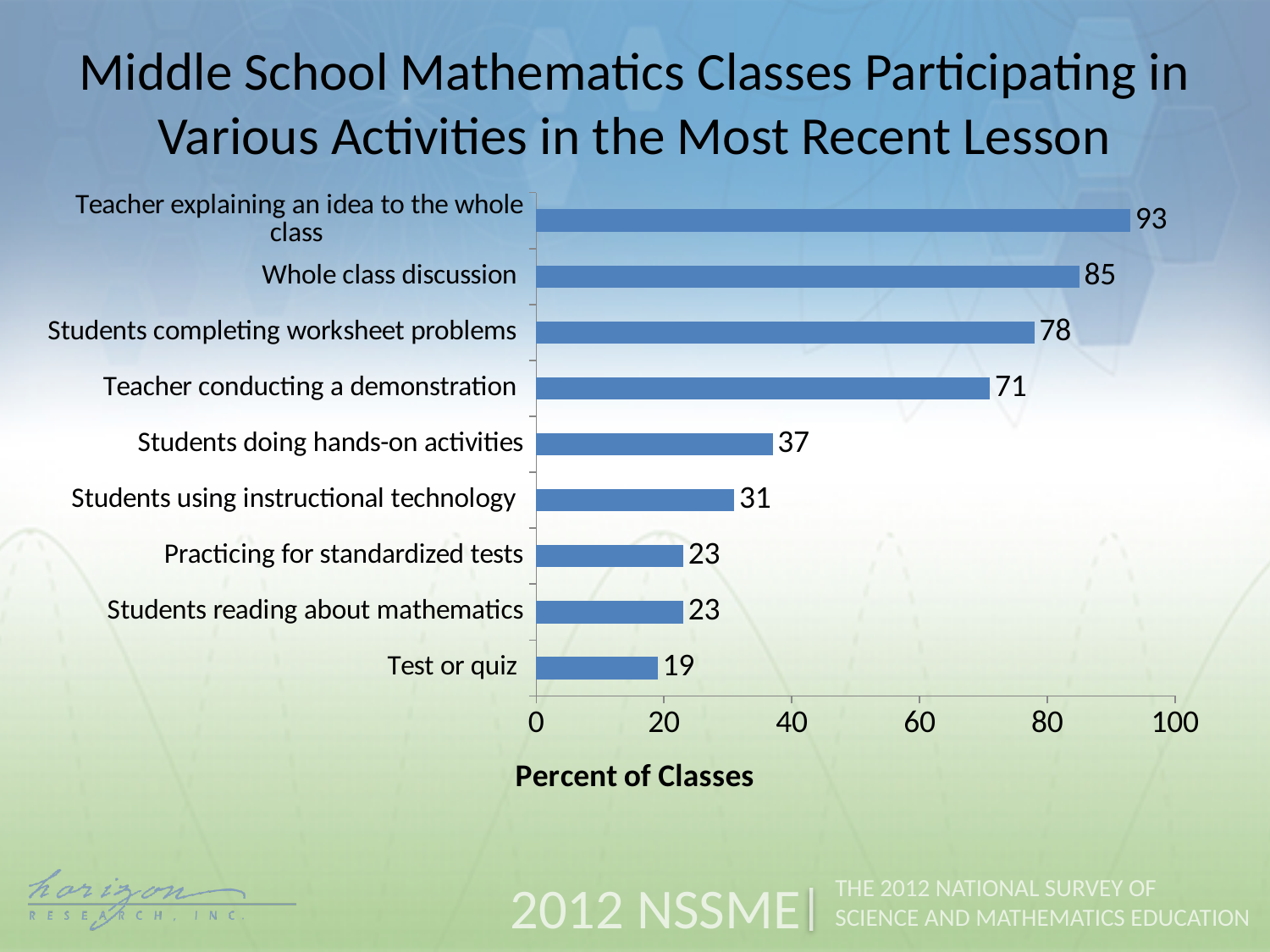
What is the value for Teacher conducting a demonstration? 71 What is the difference between Whole class discussion and Students completing worksheet problems? 7 Which is larger: Students doing hands-on activities or Students using instructional technology? Students doing hands-on activities What is the label on the horizontal axis of the chart? Percent of Classes What percent of classes had the teacher explaining an idea to the whole class? 93 Is the value for Teacher conducting a demonstration greater or less than 60? greater What is the difference between Students doing hands-on activities and Test or quiz? 18 What kind of chart is shown on the slide? Bar chart Which activity has the lowest percent of classes? Test or quiz How many activities are shown in the chart? 9 What is the value for Students using instructional technology? 31 Which activity has the highest percent of classes? Teacher explaining an idea to the whole class